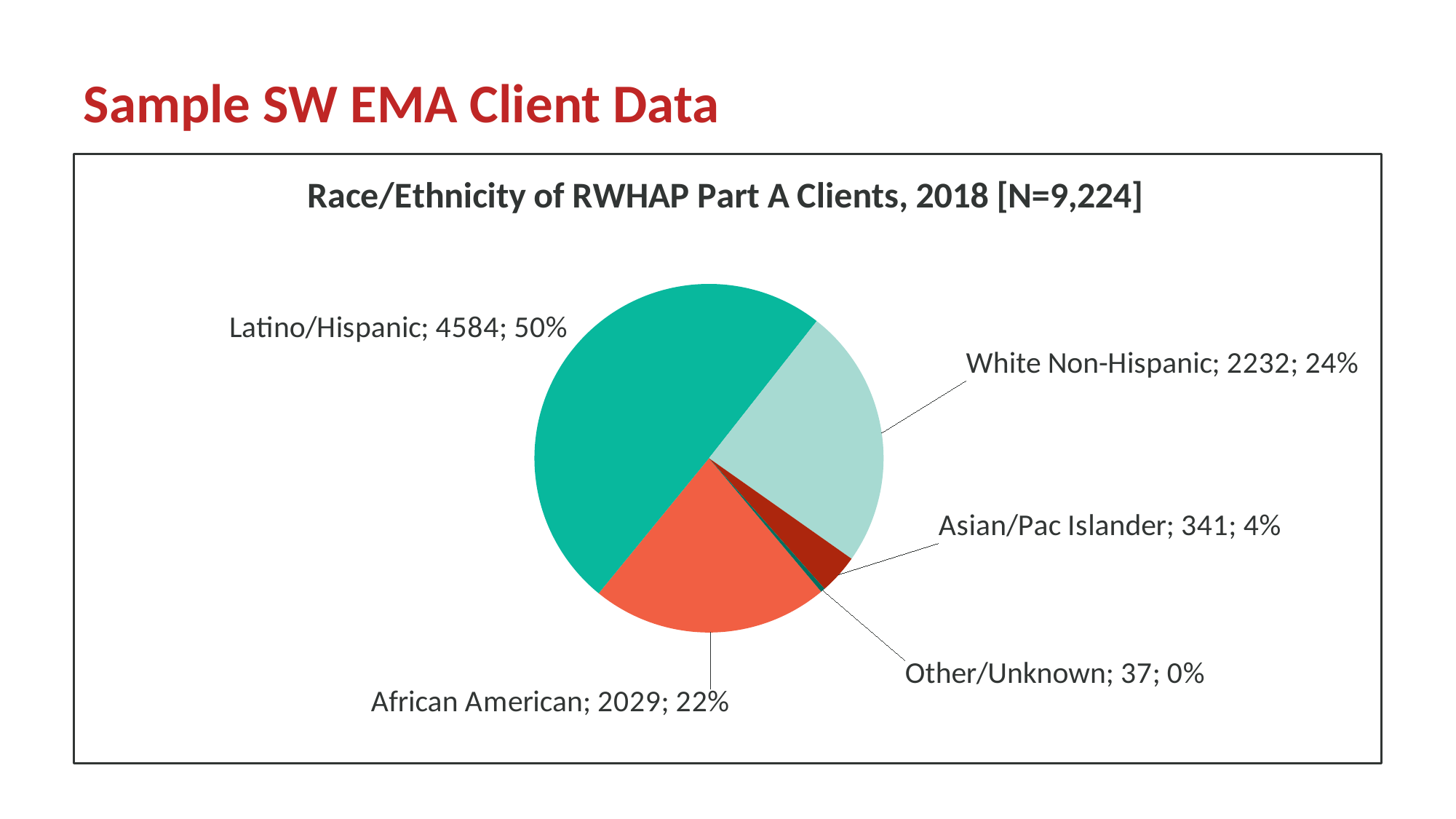
How many clients are Asian/Pac Islander? 341 Which race/ethnicity category has the smallest number of clients? Other/Unknown How many clients are Latino/Hispanic? 4584 What share of the pie does African American represent? 22% What kind of chart is shown on the slide? Pie chart What is the title of the chart? Race/Ethnicity of RWHAP Part A Clients, 2018 [N=9,224] What percentage of clients are White Non-Hispanic? 24% What is the difference in client count between White Non-Hispanic and African American? 203 What percentage is shown for Other/Unknown? 0% Which has more clients, African American or White Non-Hispanic? White Non-Hispanic Which race/ethnicity category has the largest number of clients? Latino/Hispanic How many race/ethnicity categories are shown in the pie chart? 5